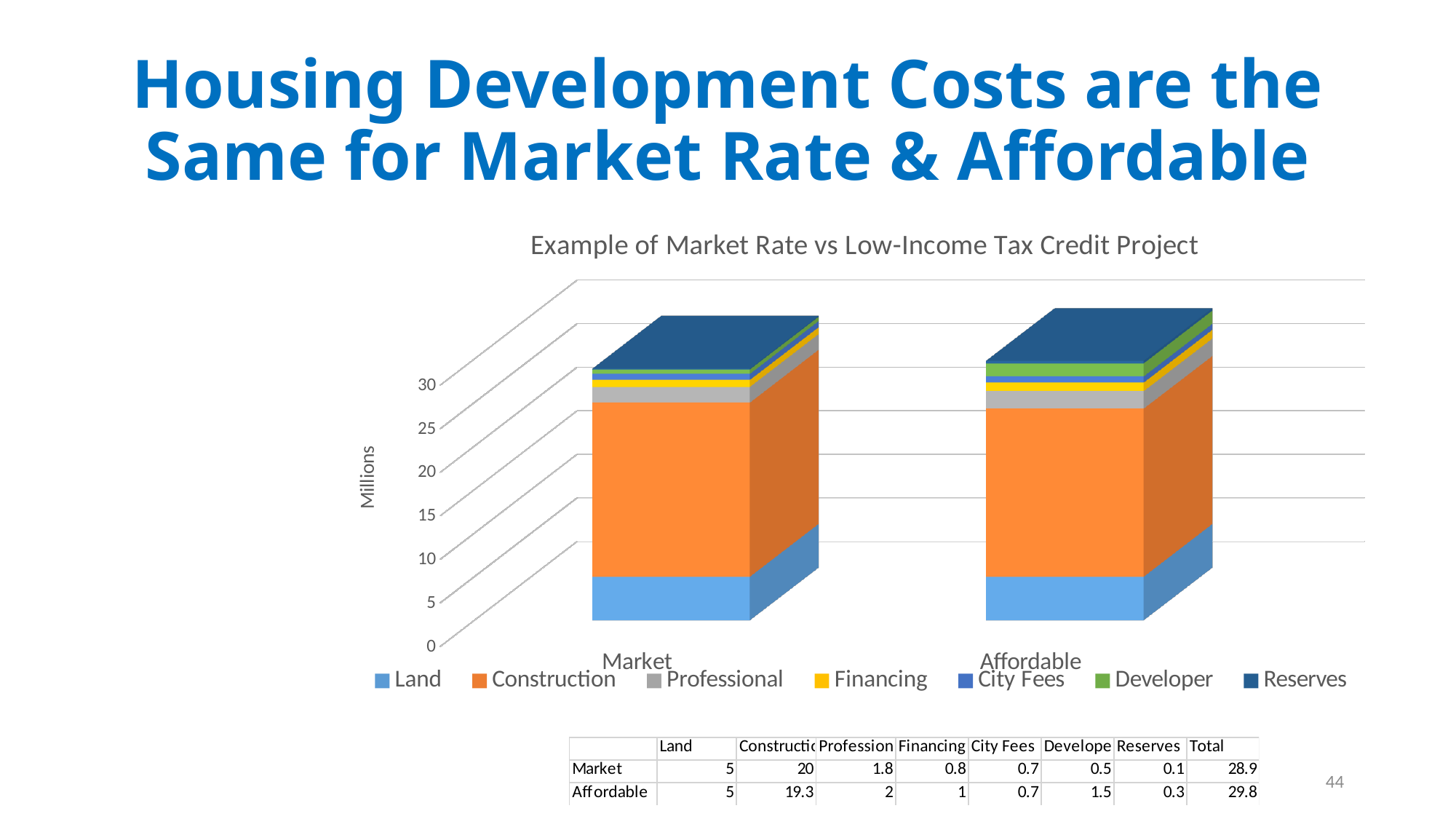
What is the Developer value for Affordable? 1.5 What is the difference between the Construction values for Market and Affordable? 0.7 What is the total of the stacked bar for Market? 28.9 Which category has the larger Reserves value, Market or Affordable? Affordable Which series is the largest component of the Market bar? Construction What kind of chart is shown on the slide? stacked bar chart What is the total of the stacked bar for Affordable? 29.8 How many categories are shown on the x axis of the chart? 2 What is the Financing value for Affordable? 1 What is the title of the chart? Example of Market Rate vs Low-Income Tax Credit Project What is the Construction value for Market? 20 How many series does the chart legend list? 7